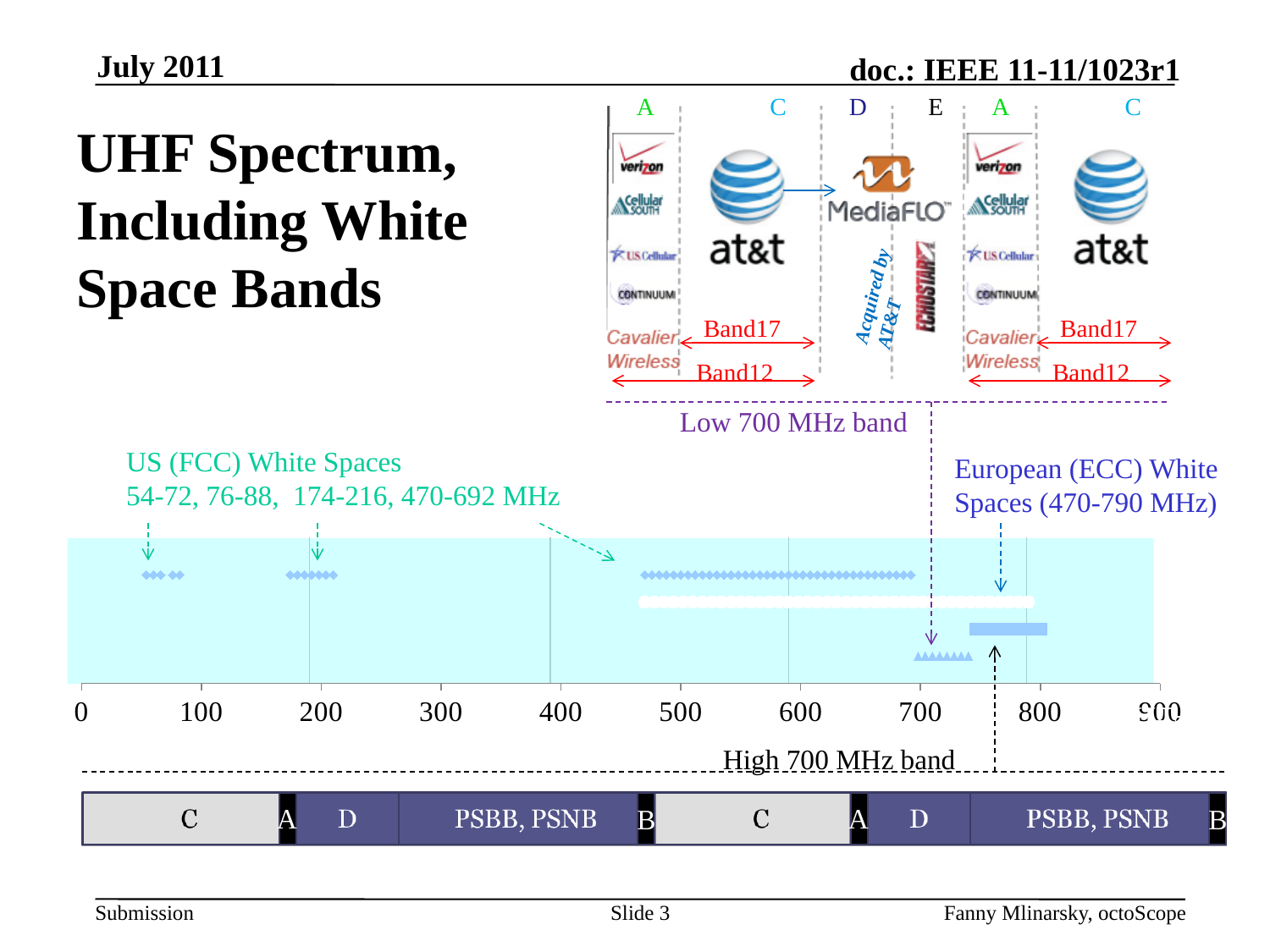
What frequency range is given for the European (ECC) White Spaces? 470-790 MHz What is the highest value shown on the x axis of the spectrum chart? 900 What is the spacing between consecutive tick labels on the x axis of the spectrum chart? 100 Is the lower limit of the highest US (FCC) White Space range greater or less than 400 on the x axis? greater Is the upper limit of the European (ECC) White Spaces greater or less than 800 on the x axis? less What frequency ranges are listed for the US (FCC) White Spaces? 54-72, 76-88, 174-216, 470-692 MHz By how many MHz does the upper limit of the European (ECC) White Spaces (790 MHz) exceed the upper limit of the highest US (FCC) White Space range (692 MHz)? 98 MHz How many separate frequency ranges are listed for the US (FCC) White Spaces? 4 What kind of chart is the spectrum chart in the lower half of the slide? scatter chart What is the lowest value shown on the x axis of the spectrum chart? 0 Which extends to a higher frequency: the European (ECC) White Spaces or the highest US (FCC) White Space range? European (ECC) White Spaces